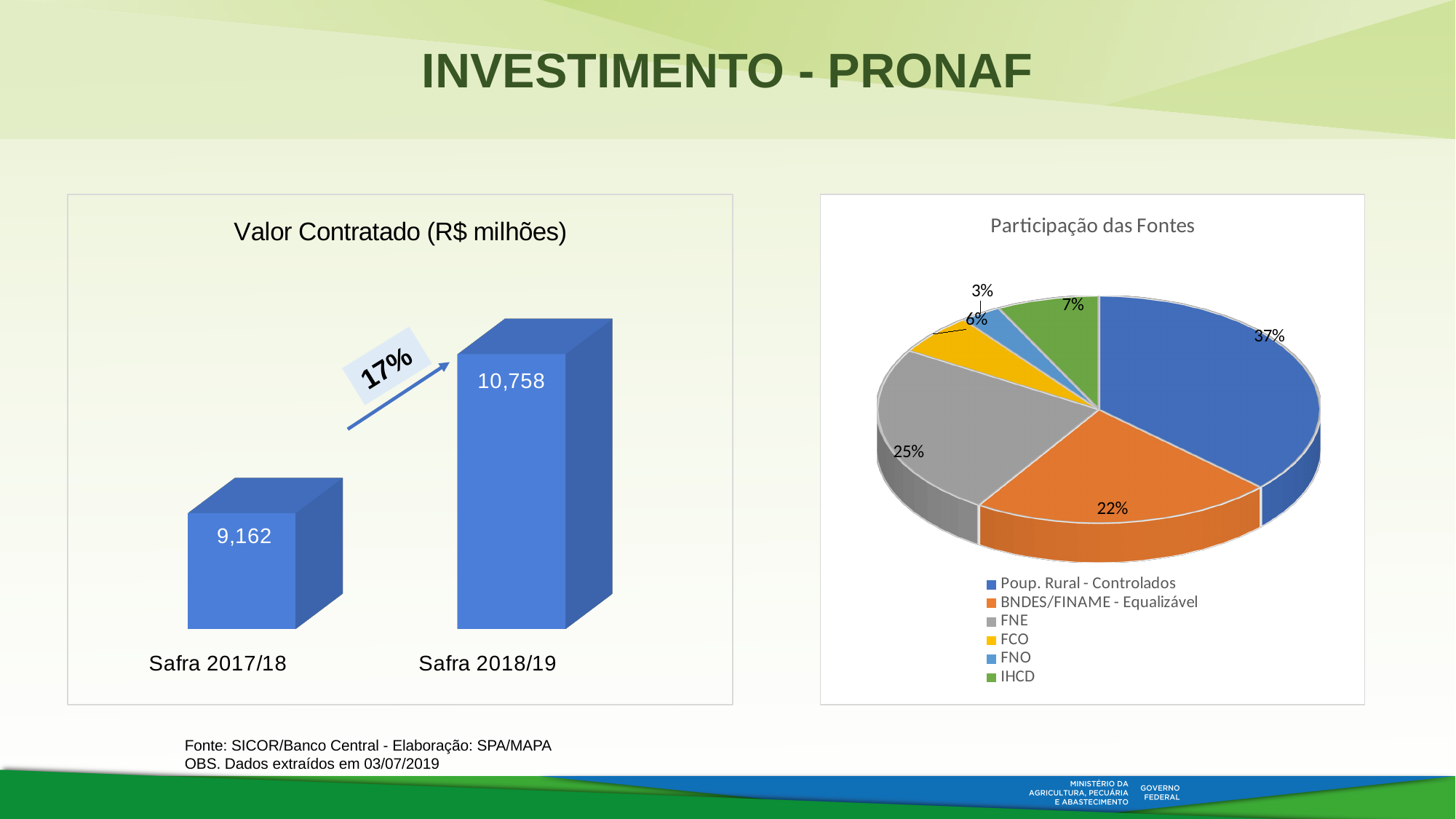
In the 'Valor Contratado (R$ milhões)' chart, how many categories are shown? 2 In the 'Participação das Fontes' chart, which source has the smallest share? FNO How many sources does the legend of the 'Participação das Fontes' chart list? 6 In the 'Valor Contratado (R$ milhões)' chart, which safra has the higher value? Safra 2018/19 In the 'Valor Contratado (R$ milhões)' chart, what is the difference between Safra 2018/19 and Safra 2017/18? 1,596 What kind of chart is 'Valor Contratado (R$ milhões)'? Bar chart In the 'Valor Contratado (R$ milhões)' chart, what percentage growth is annotated between the two safras? 17% In the 'Participação das Fontes' chart, which is larger: BNDES/FINAME - Equalizável or IHCD? BNDES/FINAME - Equalizável In the 'Participação das Fontes' chart, what share does Poup. Rural - Controlados have? 37% In the 'Valor Contratado (R$ milhões)' chart, what is the value for Safra 2017/18? 9,162 In the 'Valor Contratado (R$ milhões)' chart, what is the value for Safra 2018/19? 10,758 In the 'Participação das Fontes' chart, what share does FNE have? 25%